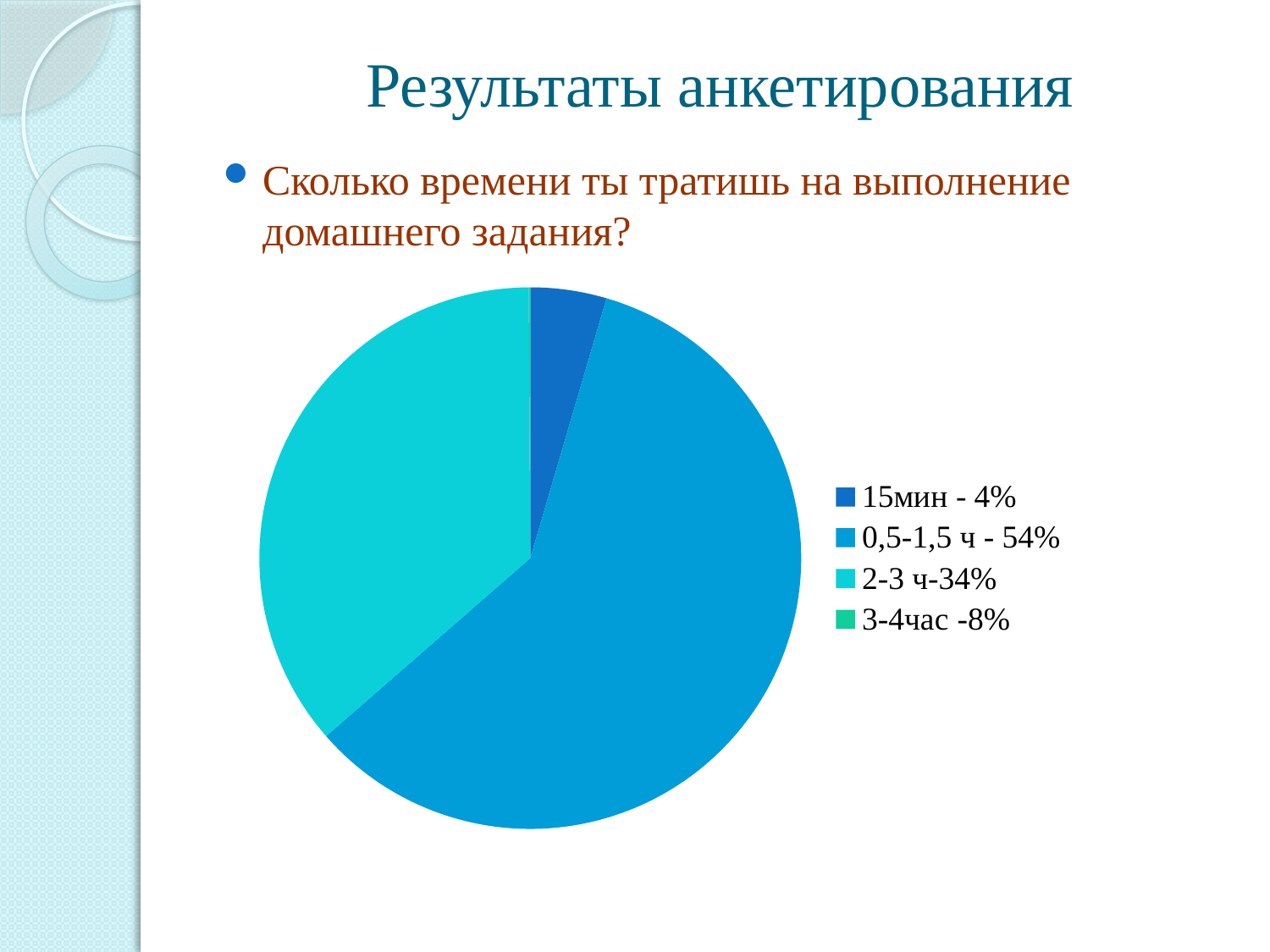
What kind of chart is shown on the slide? pie chart Which category has the largest share of the pie? 0,5-1,5 ч What percentage is shown for the category "0,5-1,5 ч"? 54% Which is larger: the share for "2-3 ч" or the share for "3-4час"? 2-3 ч How many categories does the legend of the pie chart list? 4 What percentage is shown for the category "15мин"? 4% What percentage is shown for the category "3-4час"? 8% What is the title of the slide? Результаты анкетирования What is the difference in percentage points between "0,5-1,5 ч" and "2-3 ч"? 20 What percentage is shown for the category "2-3 ч"? 34% What question is the pie chart answering, according to the bullet text on the slide? Сколько времени ты тратишь на выполнение домашнего задания?